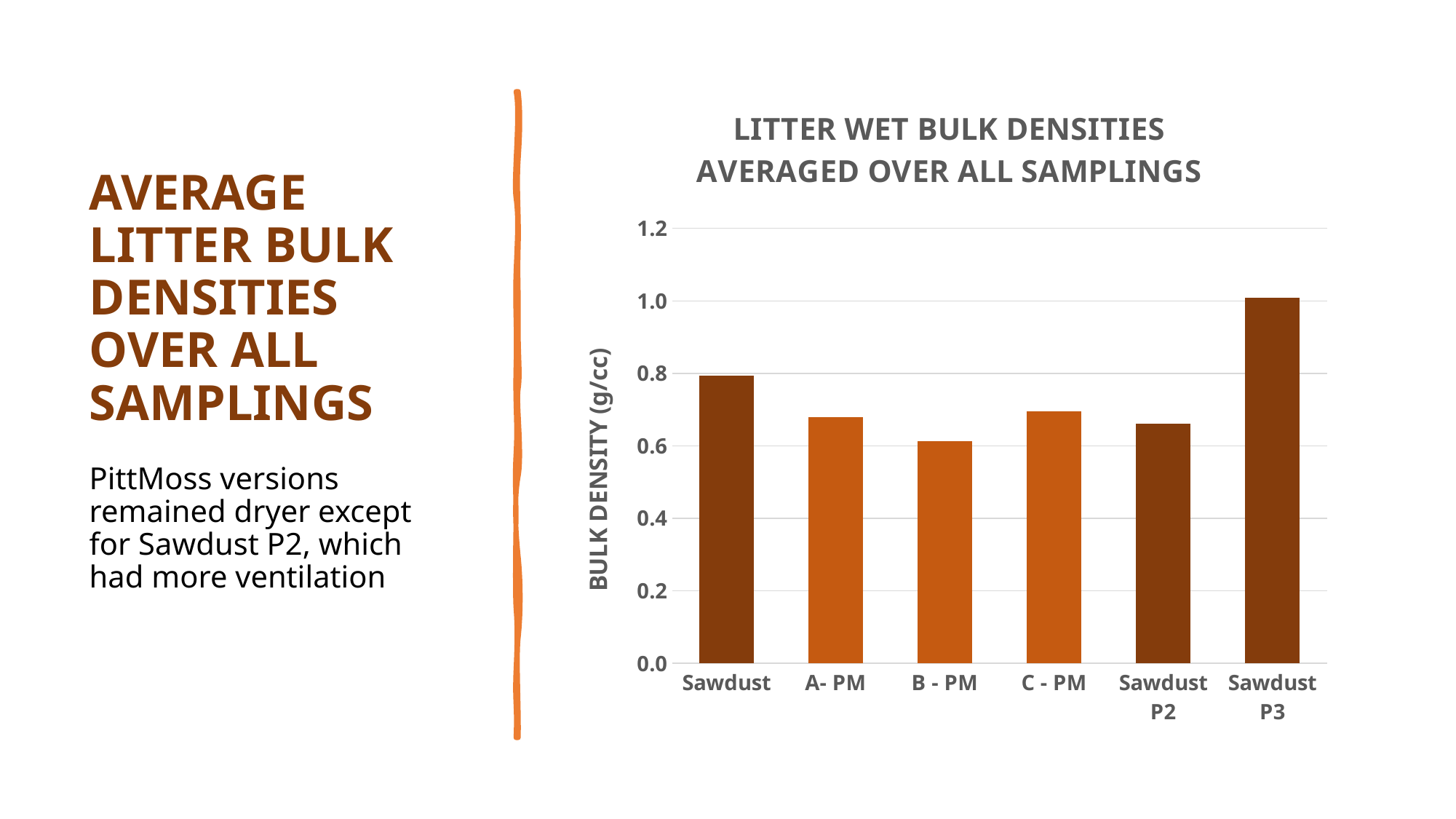
Is the value for Sawdust greater or less than 0.6? greater What kind of chart is shown on the slide? bar chart Which is larger, the value for Sawdust P3 or the value for Sawdust P2? Sawdust P3 How many categories are plotted on the x axis? 6 Which category has the highest bulk density? Sawdust P3 Is the value for B - PM greater or less than 0.8? less Which category has the lowest bulk density? B - PM Is the value for A- PM greater or less than 0.8? less What is the title of the chart? LITTER WET BULK DENSITIES AVERAGED OVER ALL SAMPLINGS What is the label on the y axis? BULK DENSITY (g/cc) Which is larger, the value for Sawdust or the value for A- PM? Sawdust